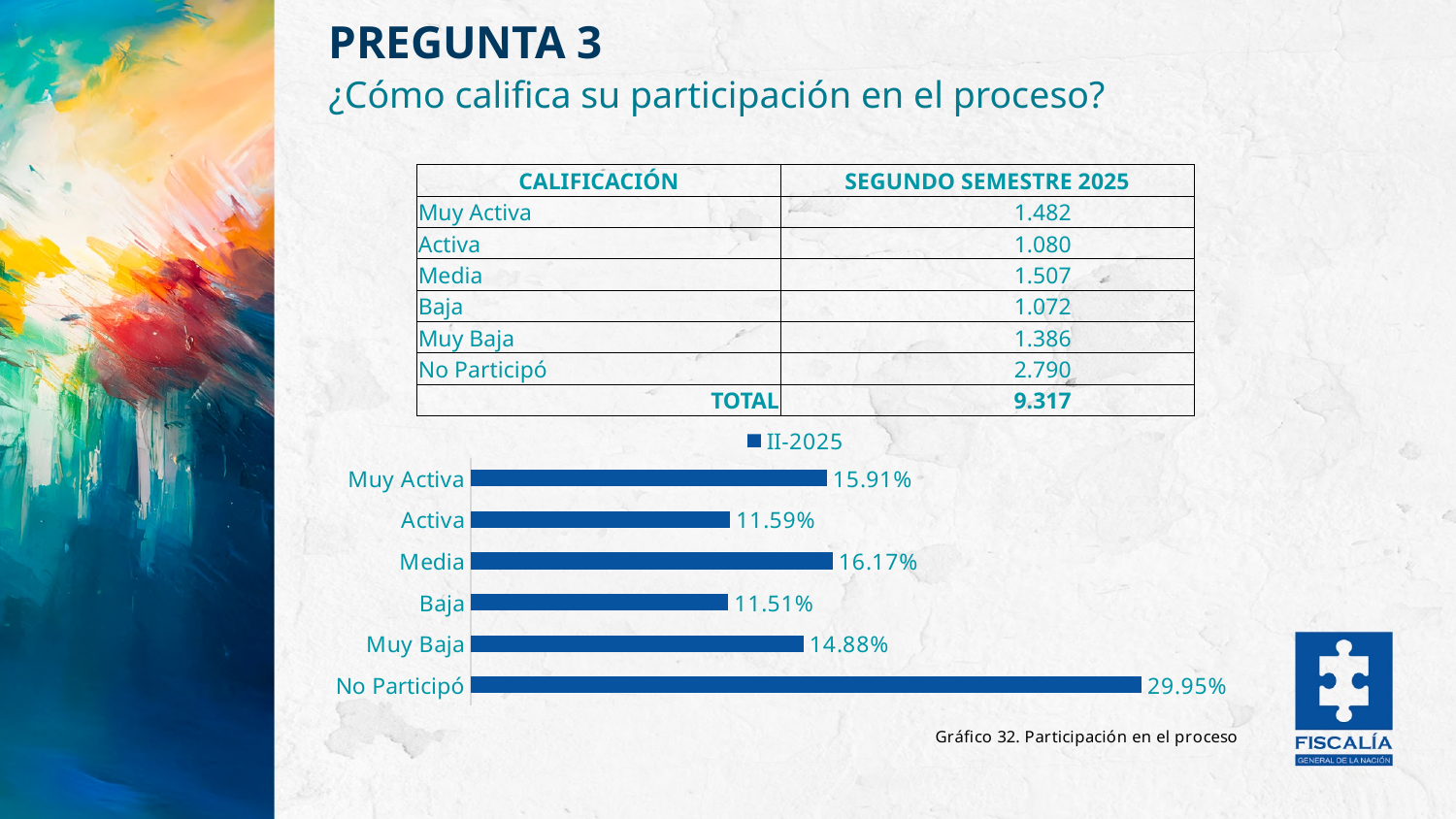
What is the caption of the chart? Gráfico 32. Participación en el proceso How many categories are shown in the chart? 6 How many series does the chart legend list? 1 What kind of chart is shown on the slide? Bar chart Which category has the lowest value in the chart? Baja What is the value for Muy Activa in the chart? 15.91% Which is larger, the value for Media or the value for Muy Baja? Media What is the difference between the values for No Participó and Muy Activa? 14.04% What is the value for Baja in the chart? 11.51% What is the name of the series shown in the chart legend? II-2025 What is the value for No Participó in the chart? 29.95% Which category has the highest value in the chart? No Participó